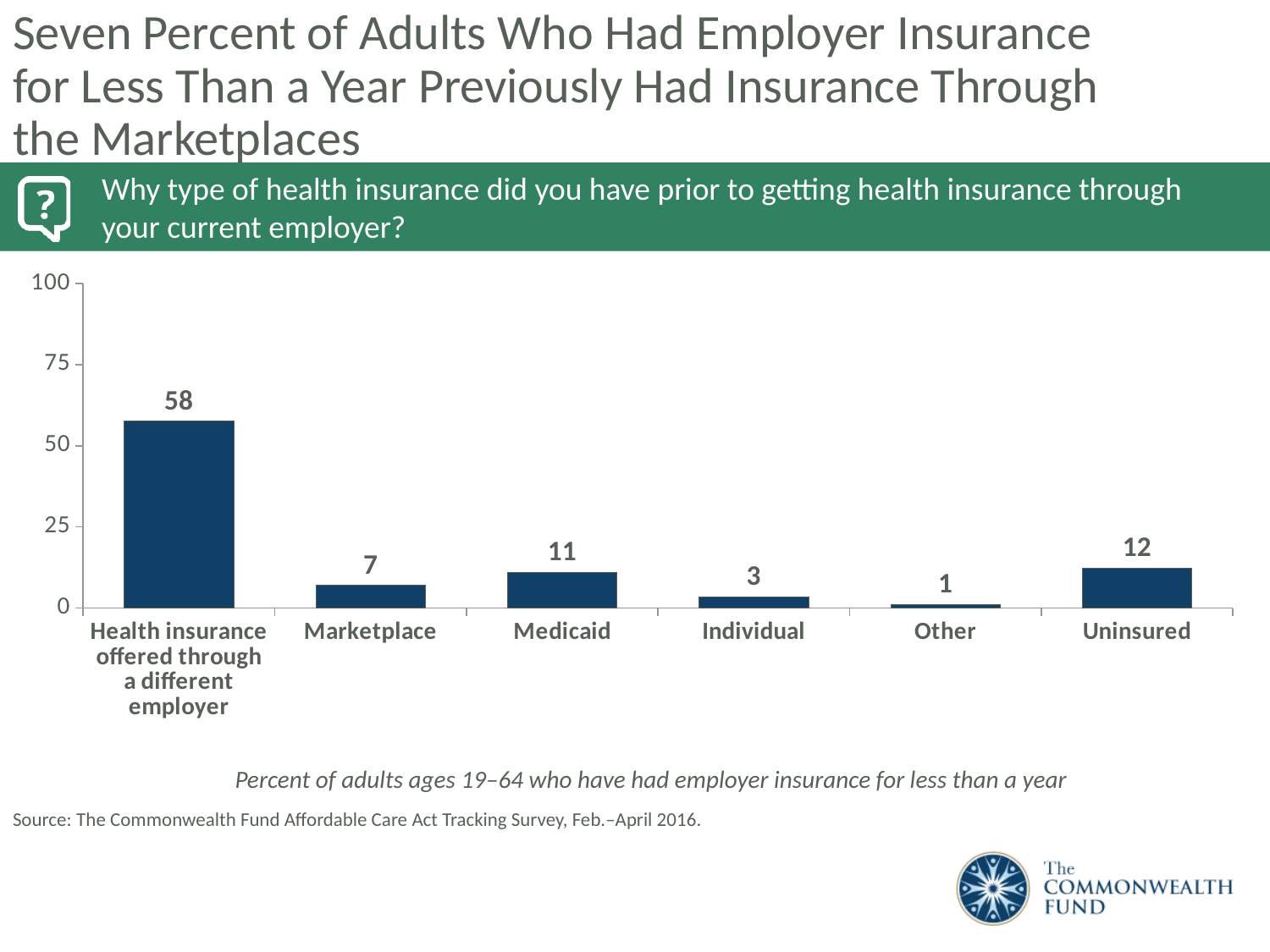
What kind of chart is shown on the slide? Bar chart What is the value for Uninsured? 12 Is the value for Health insurance offered through a different employer greater or less than 50? greater Which is larger, the value for Medicaid or the value for Marketplace? Medicaid What is the difference between the values for Health insurance offered through a different employer and Uninsured? 46 How many categories are shown on the x axis? 6 Which category has the highest value? Health insurance offered through a different employer What is the difference between the values for Medicaid and Individual? 8 What is the value for Medicaid? 11 Which category has the lowest value? Other What is the value for Health insurance offered through a different employer? 58 What is the value for Marketplace? 7